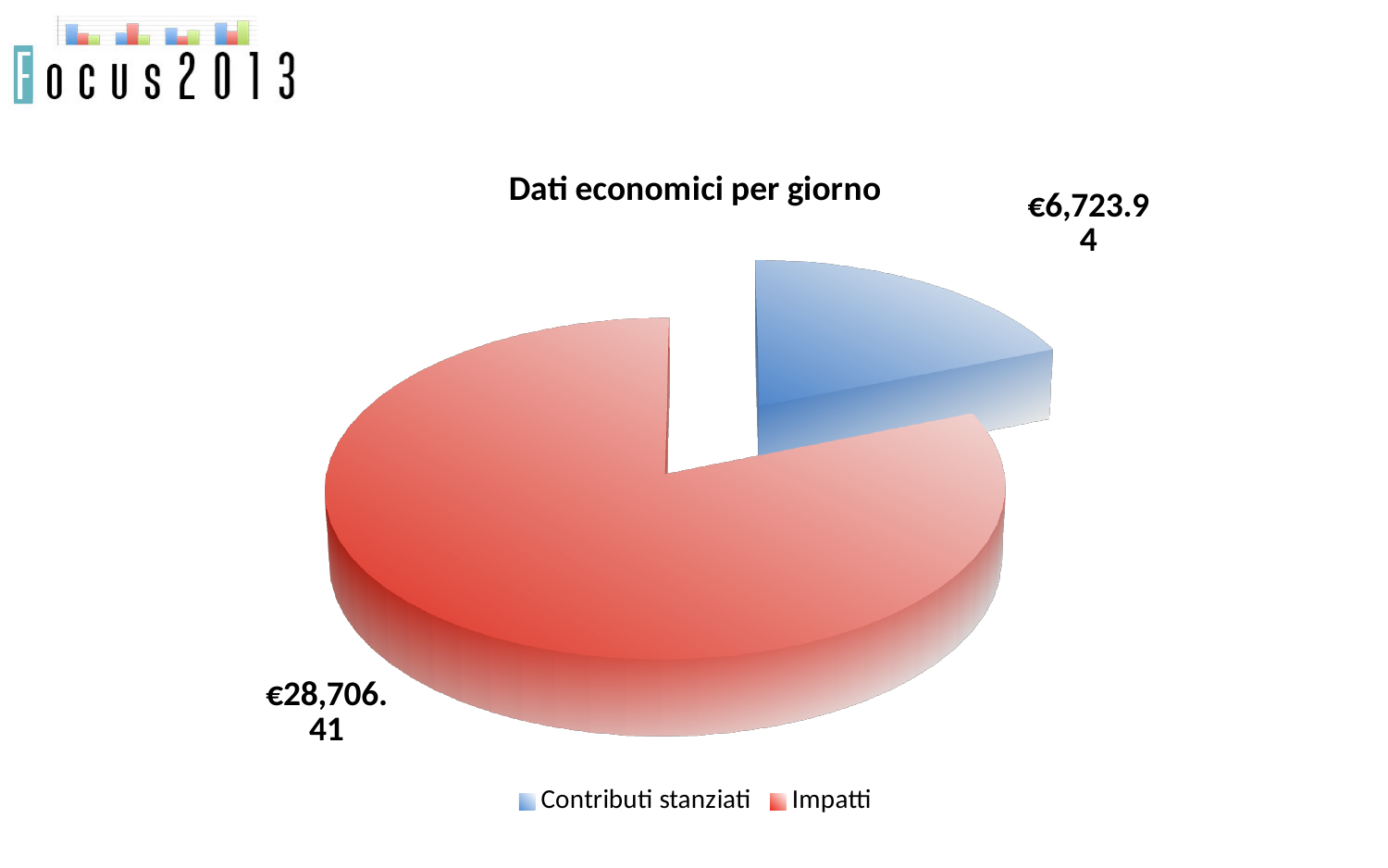
Which category has the largest slice of the pie? Impatti How many entries does the legend list? 2 Which is larger, Contributi stanziati or Impatti? Impatti How many slices does the pie chart have? 2 What is the title of the chart? Dati economici per giorno What is the value for Contributi stanziati? €6,723.94 What is the total of the two slices in the pie? €35,430.35 Which category has the smallest slice of the pie? Contributi stanziati What colour is the Impatti slice? Red What is the difference between Impatti and Contributi stanziati? €21,982.47 What type of chart is shown on the slide? Pie chart What is the value for Impatti? €28,706.41